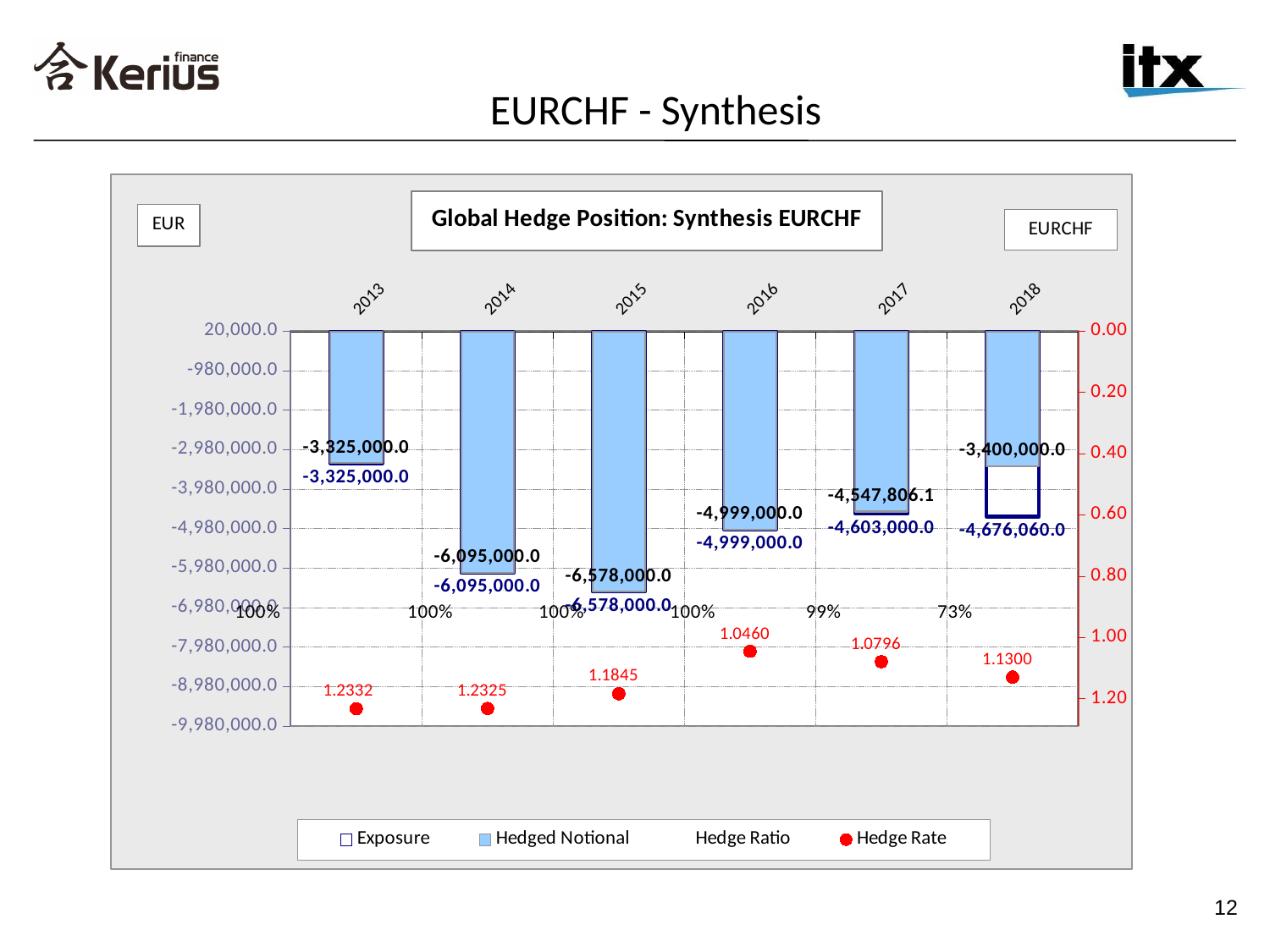
What value is labelled for both Exposure and Hedged Notional in 2015? -6,578,000.0 Which year has the lowest Hedge Rate? 2016 How many years are shown on the x axis of the chart? 6 Does the Hedge Rate rise or fall from 2013 to 2016? fall What is the Hedge Ratio shown for 2017? 99% What is the title of the chart? Global Hedge Position: Synthesis EURCHF What is the Hedge Rate value labelled for 2016? 1.0460 What is the difference between the Hedge Rate in 2015 (1.1845) and in 2016 (1.0460)? 0.1385 What is the Hedge Rate value labelled for 2013? 1.2332 Which year has the highest Hedge Rate? 2013 How many series does the chart legend list? 4 What is the Hedge Ratio shown for 2018? 73%